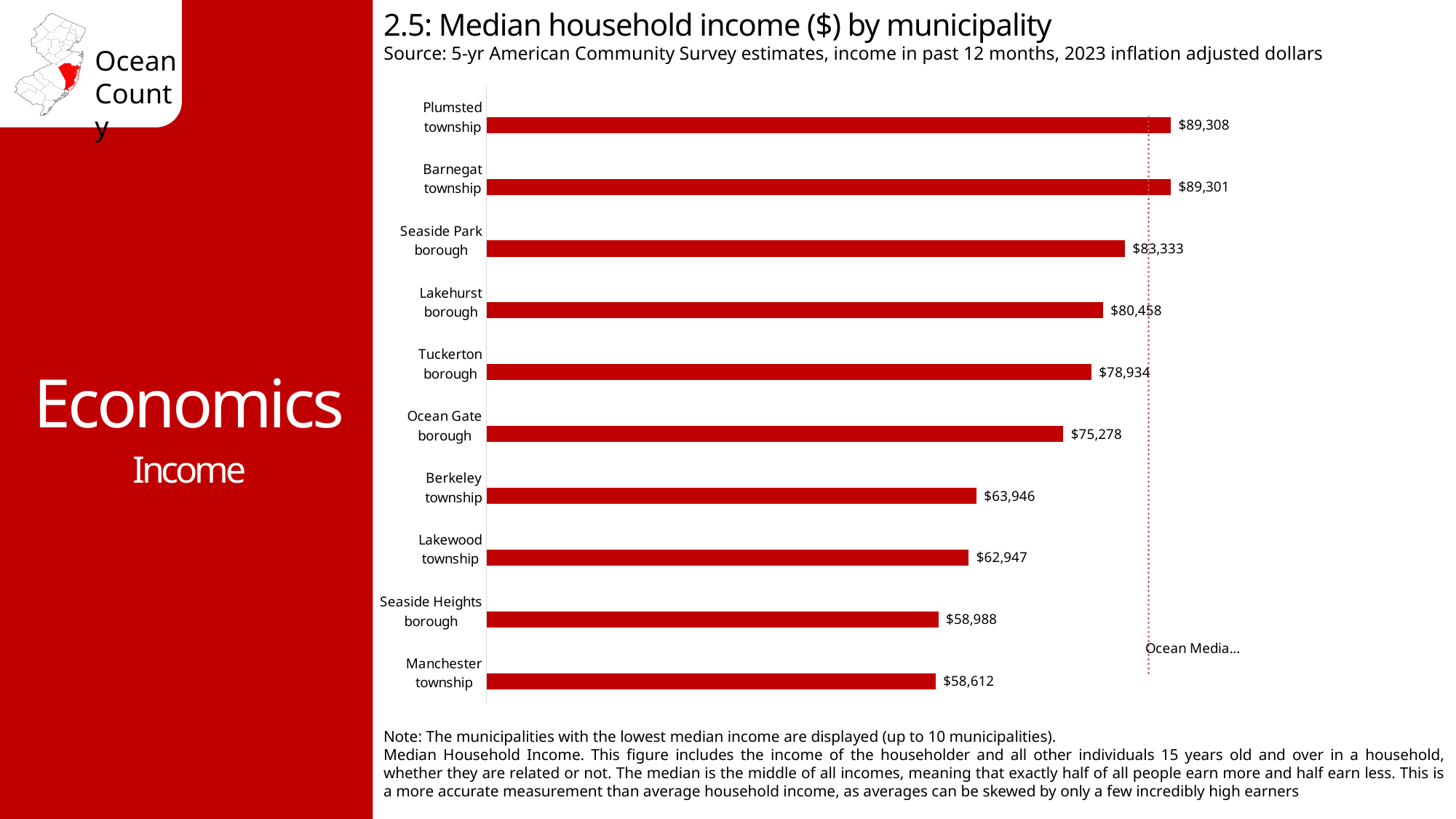
What type of chart is used on this slide? Bar chart Which has a higher median household income, Tuckerton borough or Ocean Gate borough? Tuckerton borough Which has a higher median household income, Seaside Park borough or Lakehurst borough? Seaside Park borough What is the difference in median household income between Plumsted township and Manchester township? $30,696 Which municipality has the lowest median household income on the chart? Manchester township What is the difference in median household income between Berkeley township and Lakewood township? $999 What is the title of the chart? 2.5: Median household income ($) by municipality How many municipalities are shown on the chart? 10 What is the median household income for Lakehurst borough? $80,458 Which municipality has the highest median household income on the chart? Plumsted township What is the median household income for Seaside Heights borough? $58,988 What is the median household income shown for Ocean Gate borough? $75,278